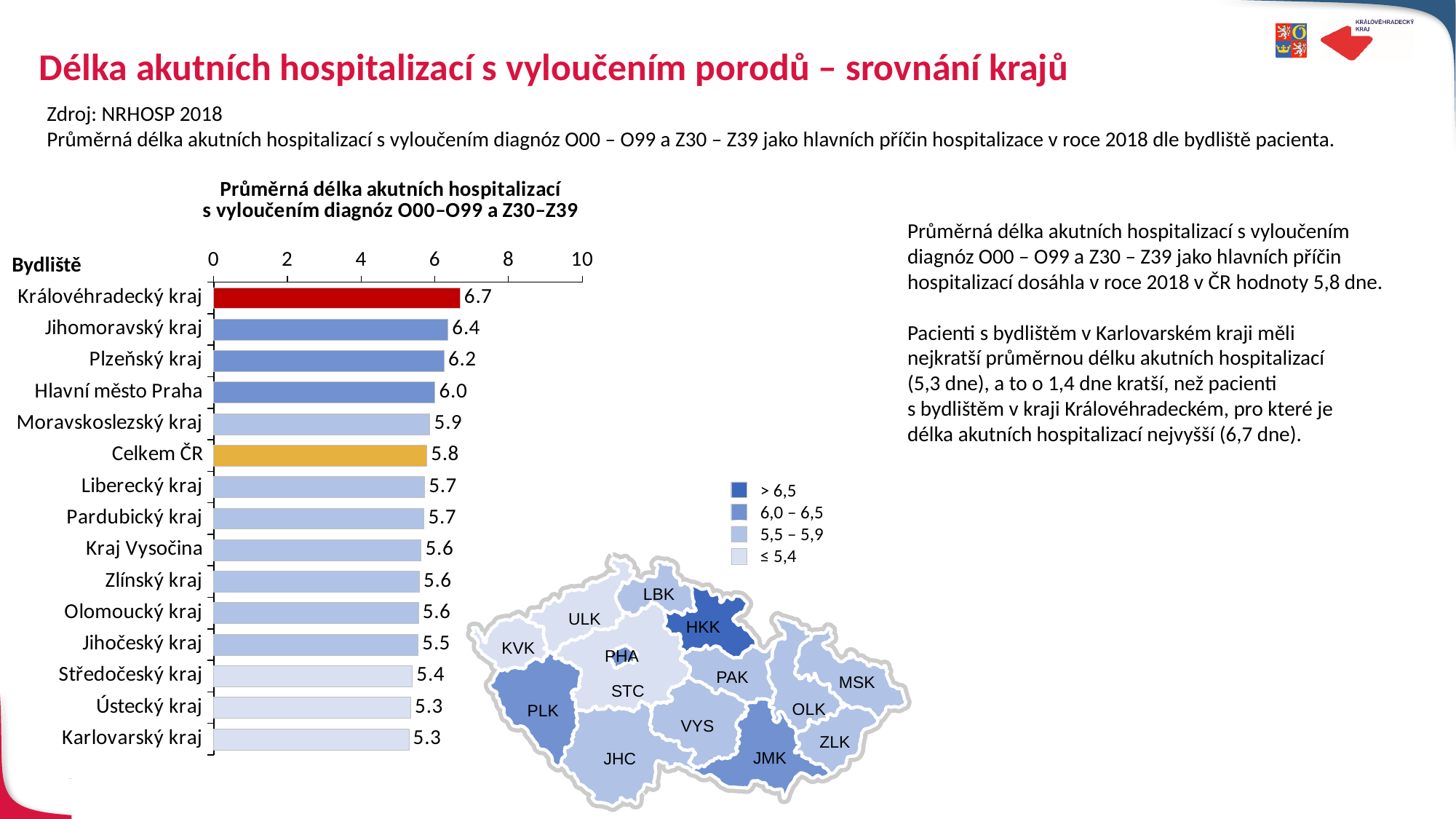
How many bars are shown in the bar chart? 15 What value is shown for Středočeský kraj in the bar chart? 5.4 What type of chart is used to compare the regions? Bar chart What is the lowest value shown in the bar chart? 5.3 What is the difference between the values for Královéhradecký kraj and Karlovarský kraj? 1.4 Which category has the highest value in the bar chart? Královéhradecký kraj What value is shown for Celkem ČR in the bar chart? 5.8 What value does the bar chart show for Hlavní město Praha? 6.0 What is the average length of acute hospitalisation for Královéhradecký kraj in the bar chart? 6.7 Which has a larger value, Plzeňský kraj or Moravskoslezský kraj? Plzeňský kraj What colour is the bar for Celkem ČR? Orange What is the difference between the values for Jihomoravský kraj and Hlavní město Praha? 0.4